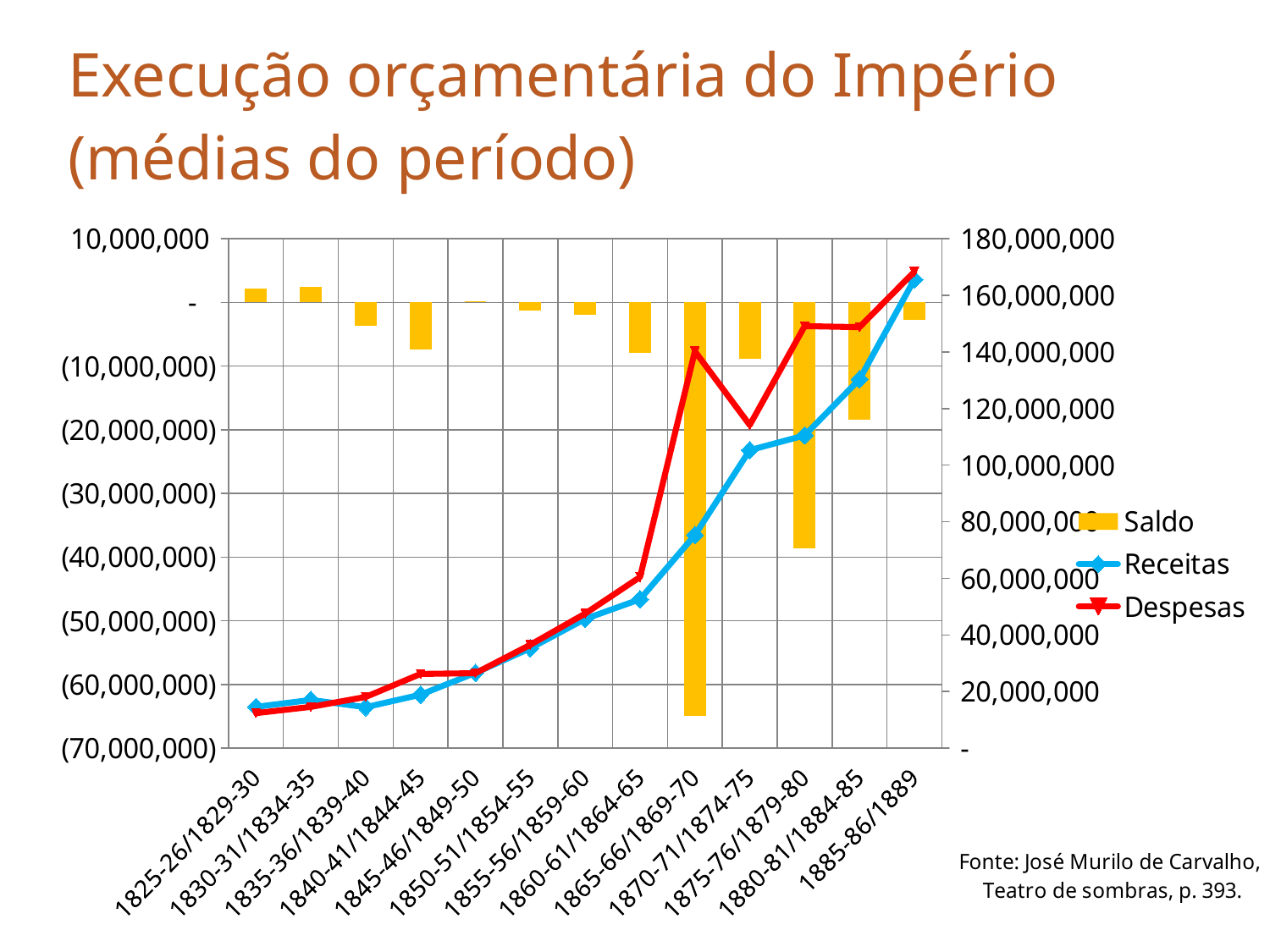
How many series does the legend list? 3 How many periods are shown on the x axis? 13 Is the value of Receitas for 1885-86/1889 greater or less than 160,000,000? greater Which series is plotted as bars? Saldo Is the value of Receitas for 1865-66/1869-70 greater or less than 80,000,000? less In which period is the Saldo lowest (most negative)? 1865-66/1869-70 What is the title of the chart? Execução orçamentária do Império (médias do período) In 1865-66/1869-70, which is larger, Receitas or Despesas? Despesas In which period are Despesas highest? 1885-86/1889 Do Receitas generally rise or fall across the periods from 1825-26/1829-30 to 1885-86/1889? Rise What kind of chart is shown on the slide? A combination chart with bars and lines